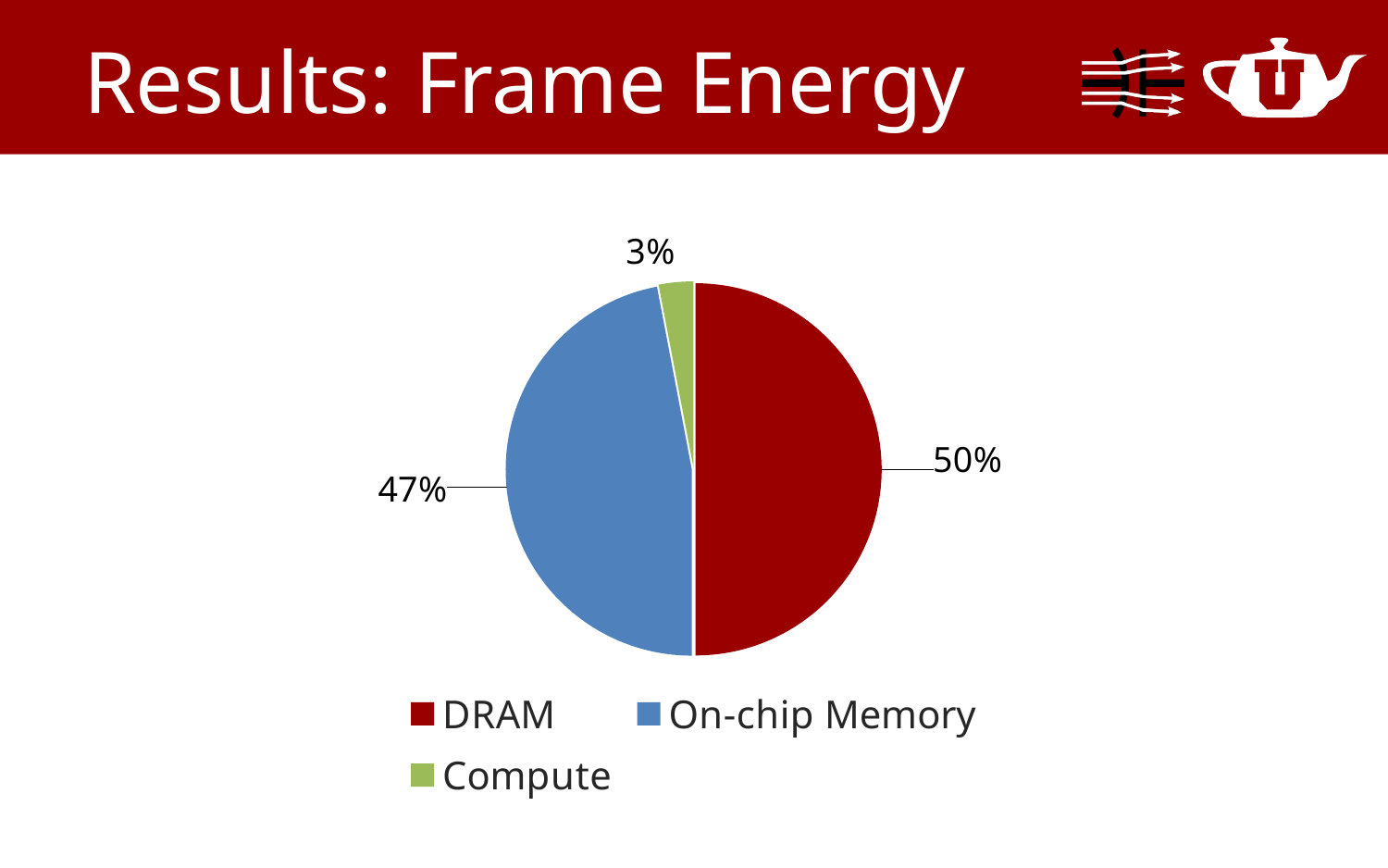
What is the difference in percentage points between the DRAM and On-chip Memory slices? 3 What share of frame energy does DRAM account for? 50% What colour is the DRAM slice? red What is the title of the slide containing the chart? Results: Frame Energy How many categories does the pie chart have? 3 What kind of chart is shown on the slide? pie chart Which is larger, the On-chip Memory slice or the Compute slice? On-chip Memory Which category has the smallest slice of the pie? Compute What share of frame energy does Compute account for? 3% What share of frame energy does On-chip Memory account for? 47% What is the difference in percentage points between the On-chip Memory and Compute slices? 44 Which category has the largest slice of the pie? DRAM